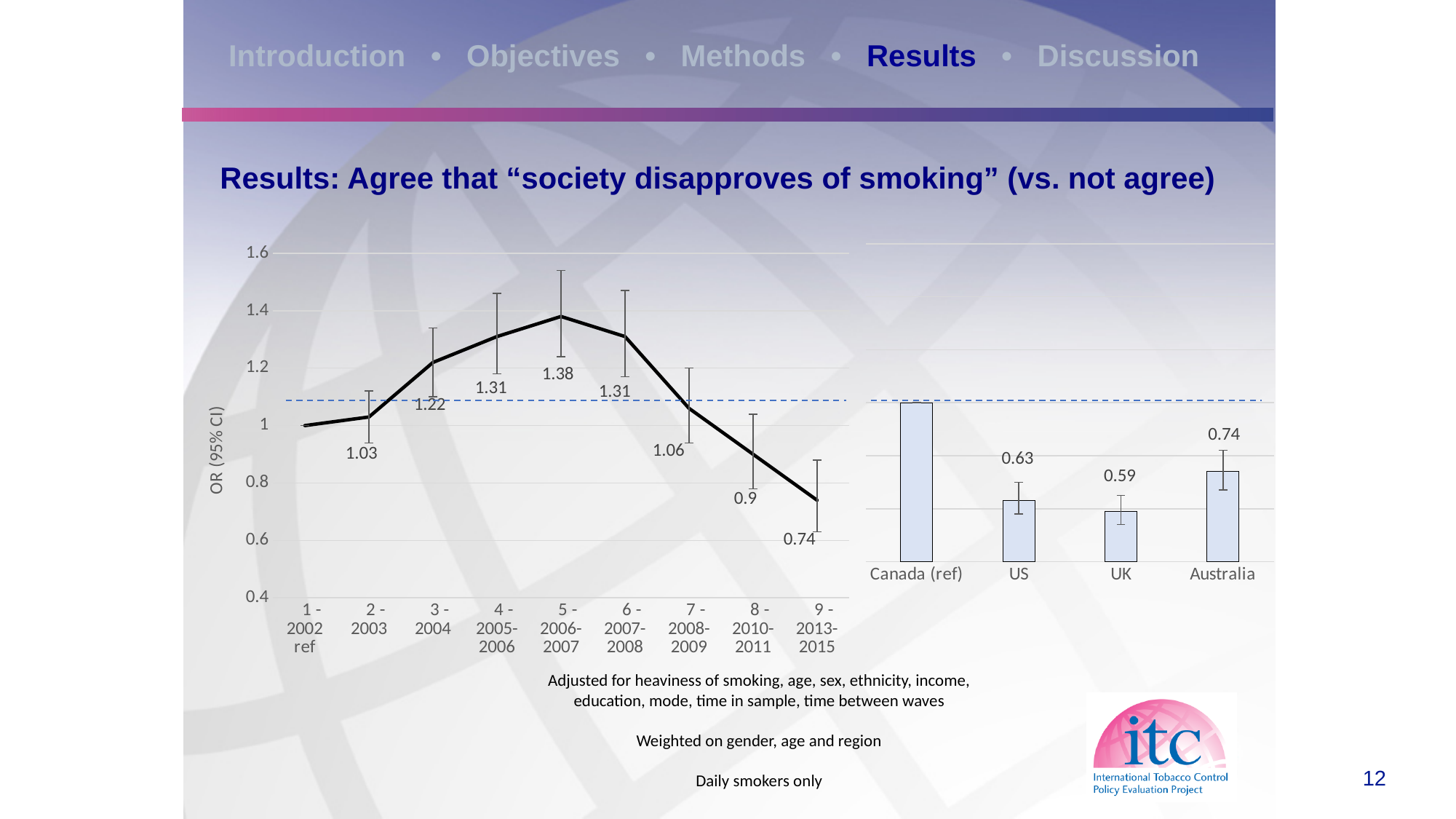
In the line chart on the left, which wave has the lowest value? 9 - 2013-2015 In the line chart on the left, what is the value for wave 8 - 2010-2011? 0.9 In the line chart on the left, which wave has the highest value? 5 - 2006-2007 What is the y-axis label of the line chart on the left? OR (95% CI) In the bar chart on the right, what is the value for UK? 0.59 In the line chart on the left, which is larger: the value for wave 3 - 2004 or wave 7 - 2008-2009? 3 - 2004 What kind of chart is the chart on the left? line chart In the bar chart on the right, what is the difference between the values for Australia and US? 0.11 In the line chart on the left, what is the difference between the values for wave 5 - 2006-2007 and wave 9 - 2013-2015? 0.64 In the line chart on the left, what is the value for wave 5 - 2006-2007? 1.38 How many waves are plotted on the x axis of the line chart on the left? 9 In the bar chart on the right, which country has the lowest value? UK